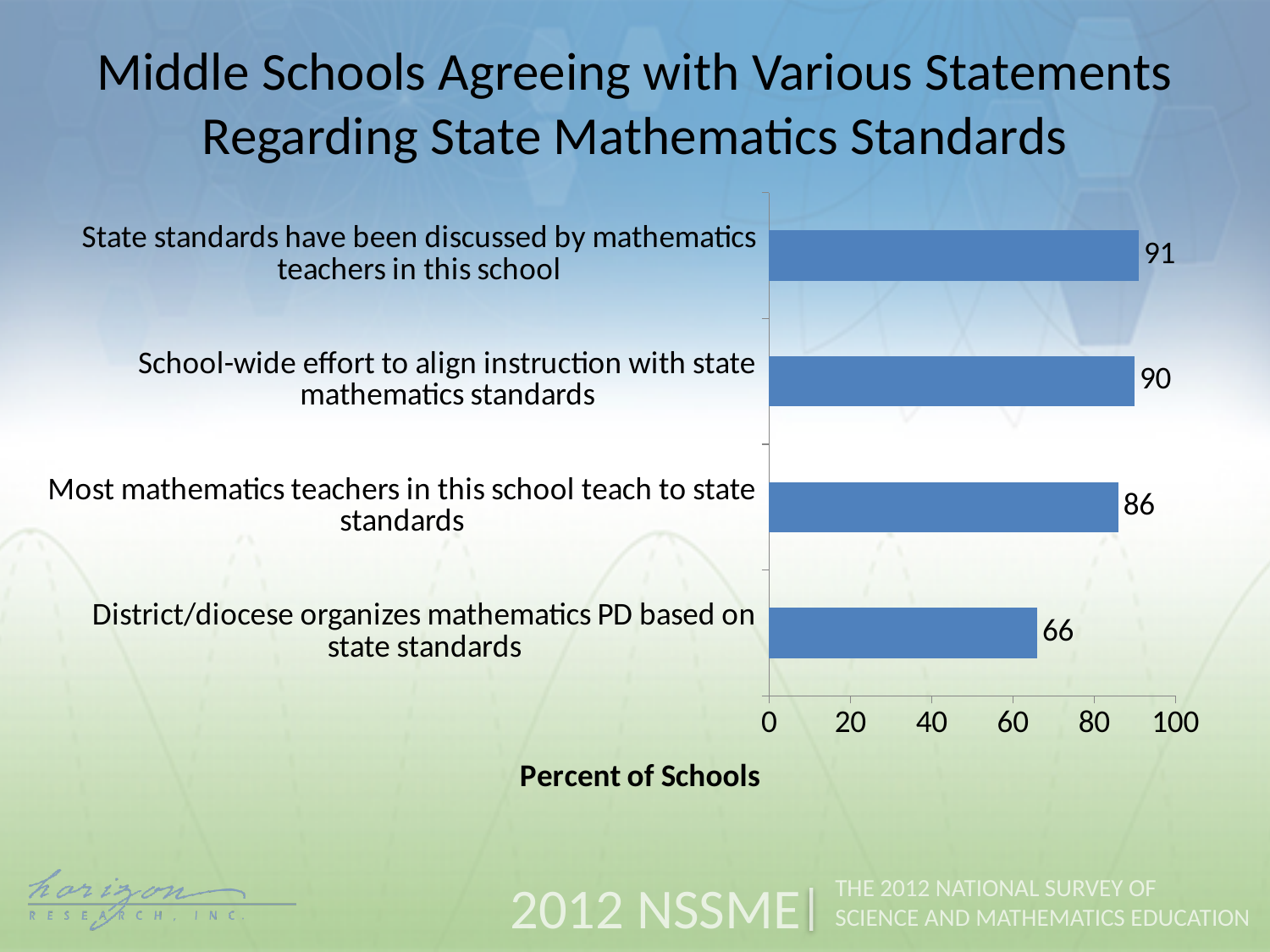
What kind of chart is shown on the slide? Bar chart Which statement has the lowest percent of schools agreeing? District/diocese organizes mathematics PD based on state standards What percent of middle schools agree that most mathematics teachers in this school teach to state standards? 86 What is the difference in percent between the highest and lowest statements? 25 Which is larger: the value for 'Most mathematics teachers in this school teach to state standards' or for 'District/diocese organizes mathematics PD based on state standards'? Most mathematics teachers in this school teach to state standards Which statement has the highest percent of schools agreeing? State standards have been discussed by mathematics teachers in this school What percent of middle schools agree that state standards have been discussed by mathematics teachers in this school? 91 What is the label of the horizontal axis? Percent of Schools How many statements are shown in the chart? 4 What percent of middle schools agree there is a school-wide effort to align instruction with state mathematics standards? 90 What percent of middle schools agree that the district/diocese organizes mathematics PD based on state standards? 66 How many percentage points higher is 'Most mathematics teachers in this school teach to state standards' than 'District/diocese organizes mathematics PD based on state standards'? 20